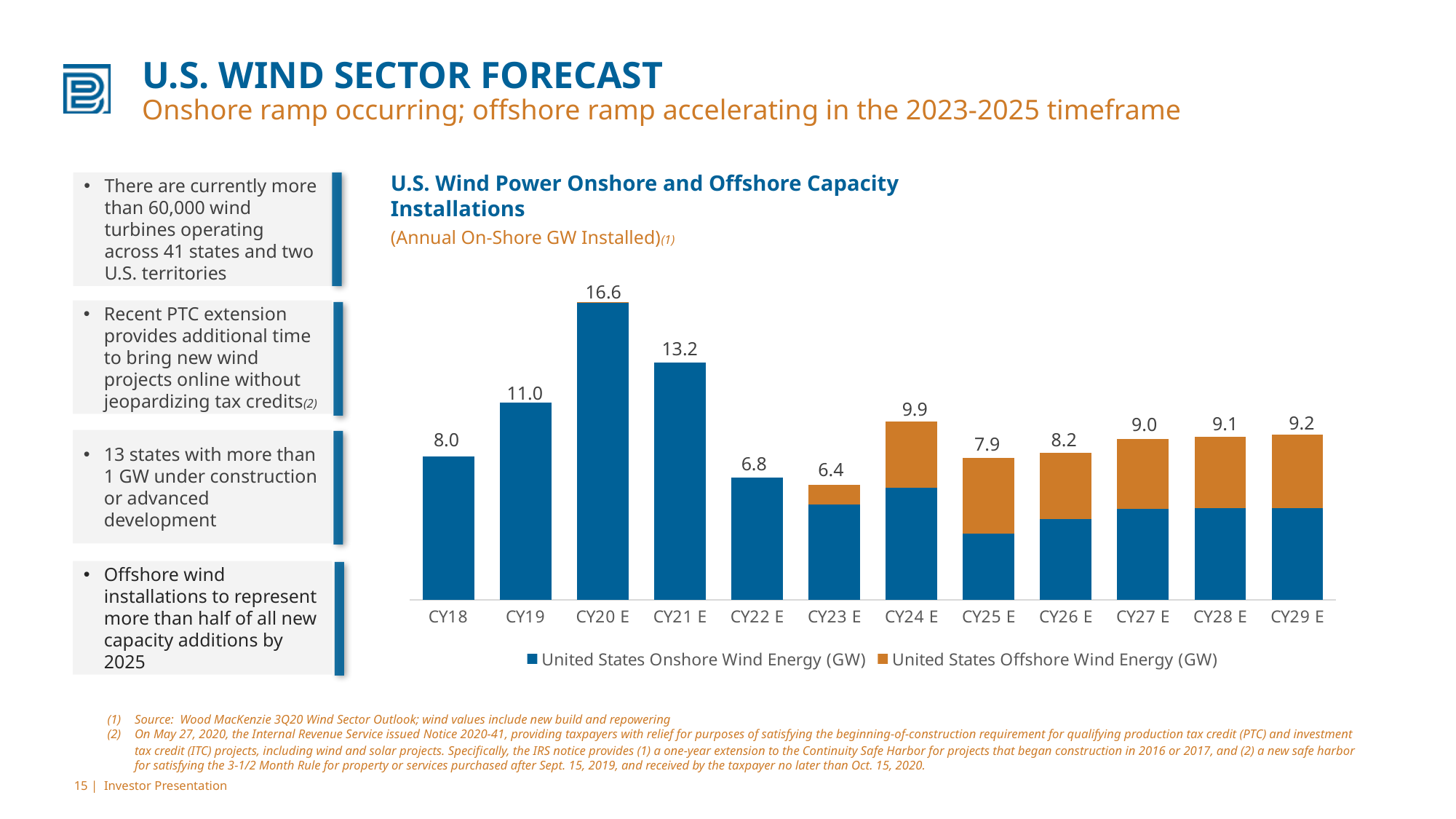
What kind of chart is shown? Stacked bar chart Which series is shown in orange? United States Offshore Wind Energy (GW) How many years are shown on the x axis? 12 Which year has the lowest total value? CY23 E What is the total labeled value for CY20 E? 16.6 What is the difference between the total values for CY20 E and CY21 E? 3.4 Which has a larger total value, CY19 or CY24 E? CY19 What is the total labeled value for CY25 E? 7.9 Do the total values rise or fall from CY25 E to CY29 E? Rise What is the total labeled value for CY18? 8.0 How many series does the legend list? 2 Which year has the highest total value? CY20 E